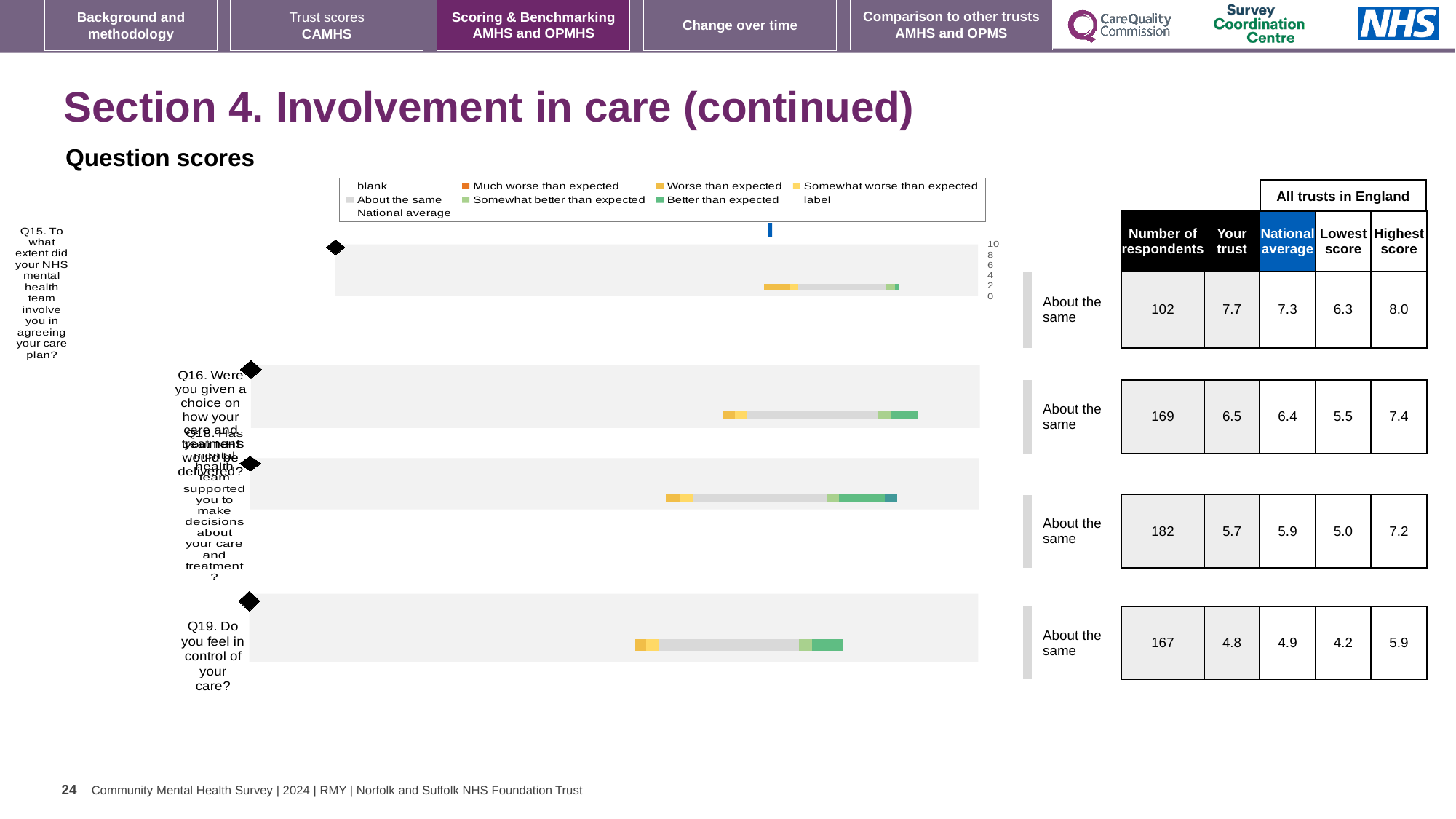
What benchmark category is shown for Q16? About the same What is the difference between the highest and lowest scores for Q19? 1.7 How many respondents answered Q18 (supported you to make decisions about your care and treatment)? 182 What is the 'Your trust' score for Q15 (involving you in agreeing your care plan)? 7.7 Which question has the lowest 'Your trust' score? Q19 How many questions (categories) are plotted in the chart? 4 What is the difference between the 'Your trust' score and the national average for Q15? 0.4 What is the national average score for Q16 (choice on how your care and treatment would be delivered)? 6.4 For Q18, which is larger: the 'Your trust' score or the national average? National average What kind of chart is shown on the slide? bar chart Which question has the highest 'Your trust' score? Q15 What is the highest score among all trusts in England for Q19 (feeling in control of your care)? 5.9